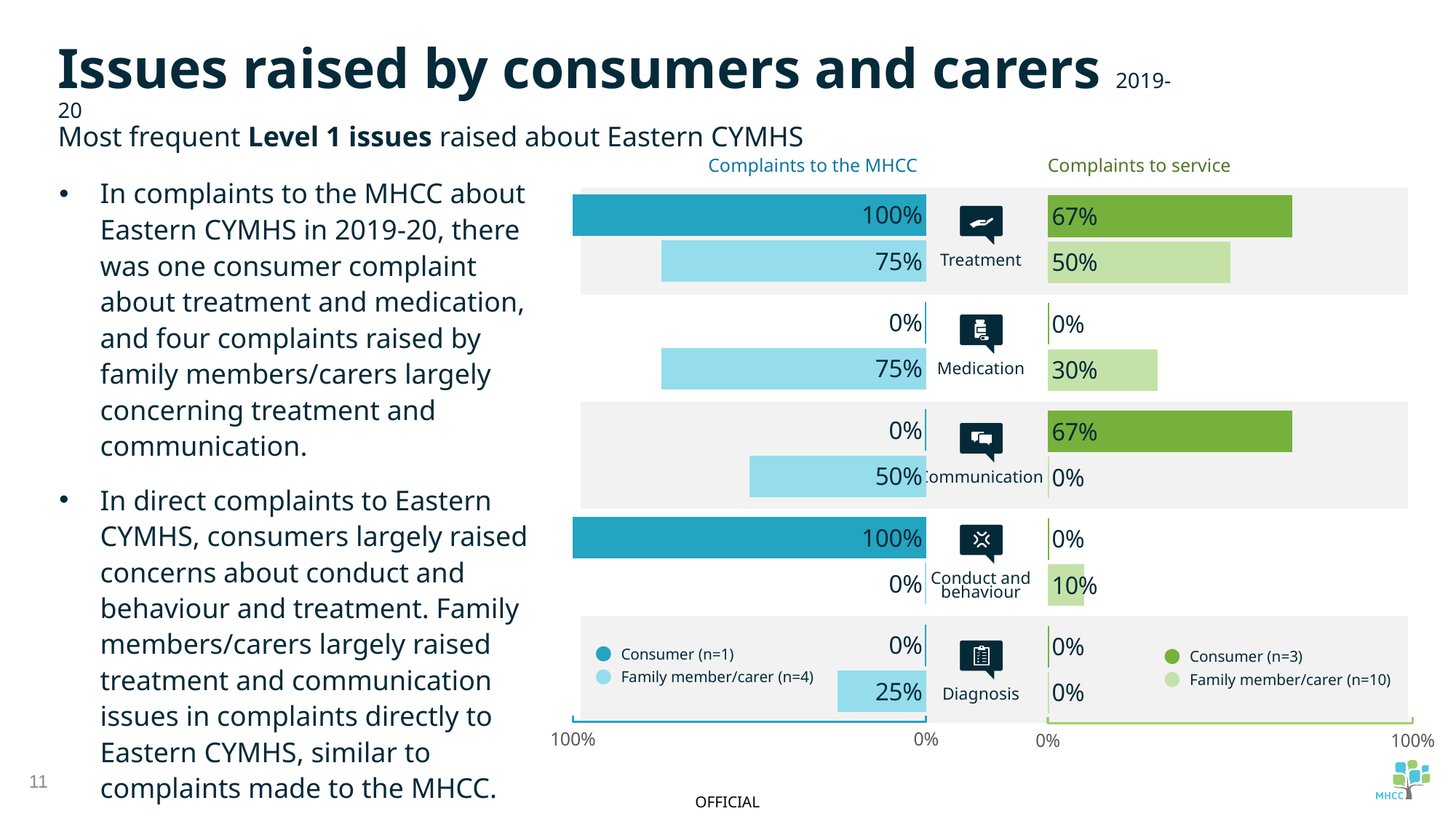
In the 'Complaints to the MHCC' chart, what is the Consumer value for Treatment? 100% In the 'Complaints to the MHCC' chart, which category has the lowest Family member/carer value? Conduct and behaviour In the 'Complaints to service' chart, which category has the highest Family member/carer value? Treatment What kind of chart is the 'Complaints to the MHCC' chart? Bar chart In the 'Complaints to service' chart, what is the Family member/carer value for Medication? 30% In the 'Complaints to service' chart, what is the Consumer value for Communication? 67% How many series does the legend of the 'Complaints to service' chart list? 2 In the 'Complaints to the MHCC' chart, what is the Family member/carer value for Medication? 75% In the 'Complaints to service' chart, is the Family member/carer value for Treatment larger or smaller than the Family member/carer value for Medication? larger In the 'Complaints to the MHCC' chart, what is the difference between the Consumer and Family member/carer values for Treatment? 25% How many categories are shown in the 'Complaints to the MHCC' chart? 5 In the 'Complaints to service' chart, what is the difference between the Consumer and Family member/carer values for Treatment? 17%